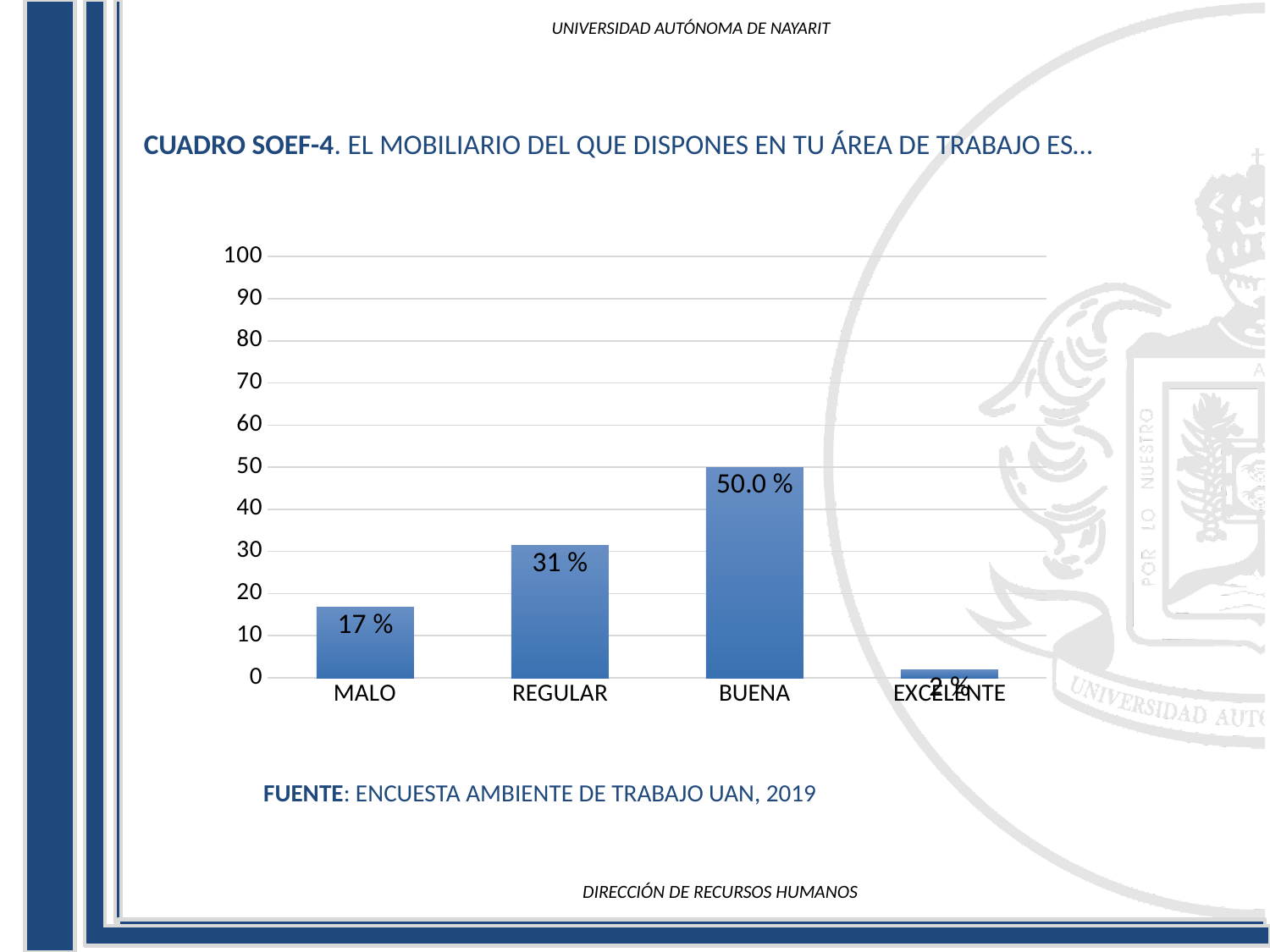
What is the difference between the values for BUENA and MALO? 33 % What is the value shown for BUENA? 50.0 % Which category has the lowest value? EXCELENTE What kind of chart is shown on the slide? bar chart What is the value shown for MALO? 17 % What is the value shown for REGULAR? 31 % Which category has the highest value? BUENA What is the difference between the values for REGULAR and MALO? 14 % Which is larger, the value for REGULAR or the value for MALO? REGULAR Is the value for EXCELENTE greater or less than 10? less What is the source cited below the chart? ENCUESTA AMBIENTE DE TRABAJO UAN, 2019 How many categories are shown on the x axis? 4